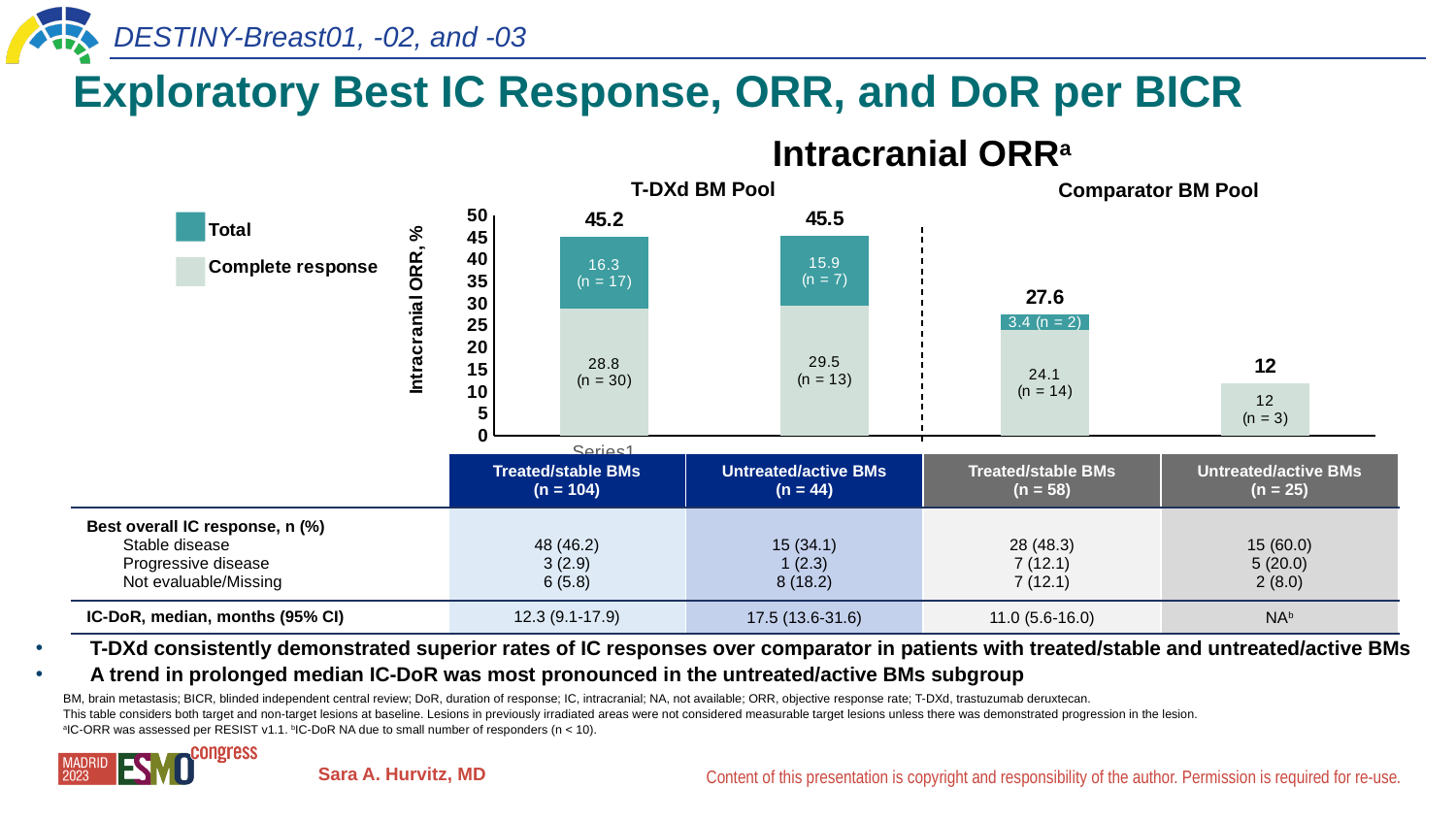
How many bars are plotted in the Intracranial ORR chart? 4 How many entries does the legend of the Intracranial ORR chart list? 2 Is the total intracranial ORR for the Comparator BM Pool untreated/active BMs group greater or less than 15? less What is the total intracranial ORR for the T-DXd BM Pool untreated/active BMs group? 45.5 What is the total intracranial ORR for the Comparator BM Pool treated/stable BMs group? 27.6 Which is larger: the total intracranial ORR for the T-DXd untreated/active BMs group or the Comparator untreated/active BMs group? T-DXd untreated/active BMs What type of chart is used to show Intracranial ORR? Stacked bar chart Which group has the lowest total intracranial ORR? Comparator BM Pool untreated/active BMs What is the difference in total intracranial ORR between the T-DXd treated/stable BMs group (45.2) and the Comparator treated/stable BMs group (27.6)? 17.6 What is the total intracranial ORR for the T-DXd BM Pool treated/stable BMs group? 45.2 What is the complete response rate shown for the T-DXd BM Pool treated/stable BMs bar? 16.3 What is the complete response rate shown for the Comparator BM Pool treated/stable BMs bar? 3.4